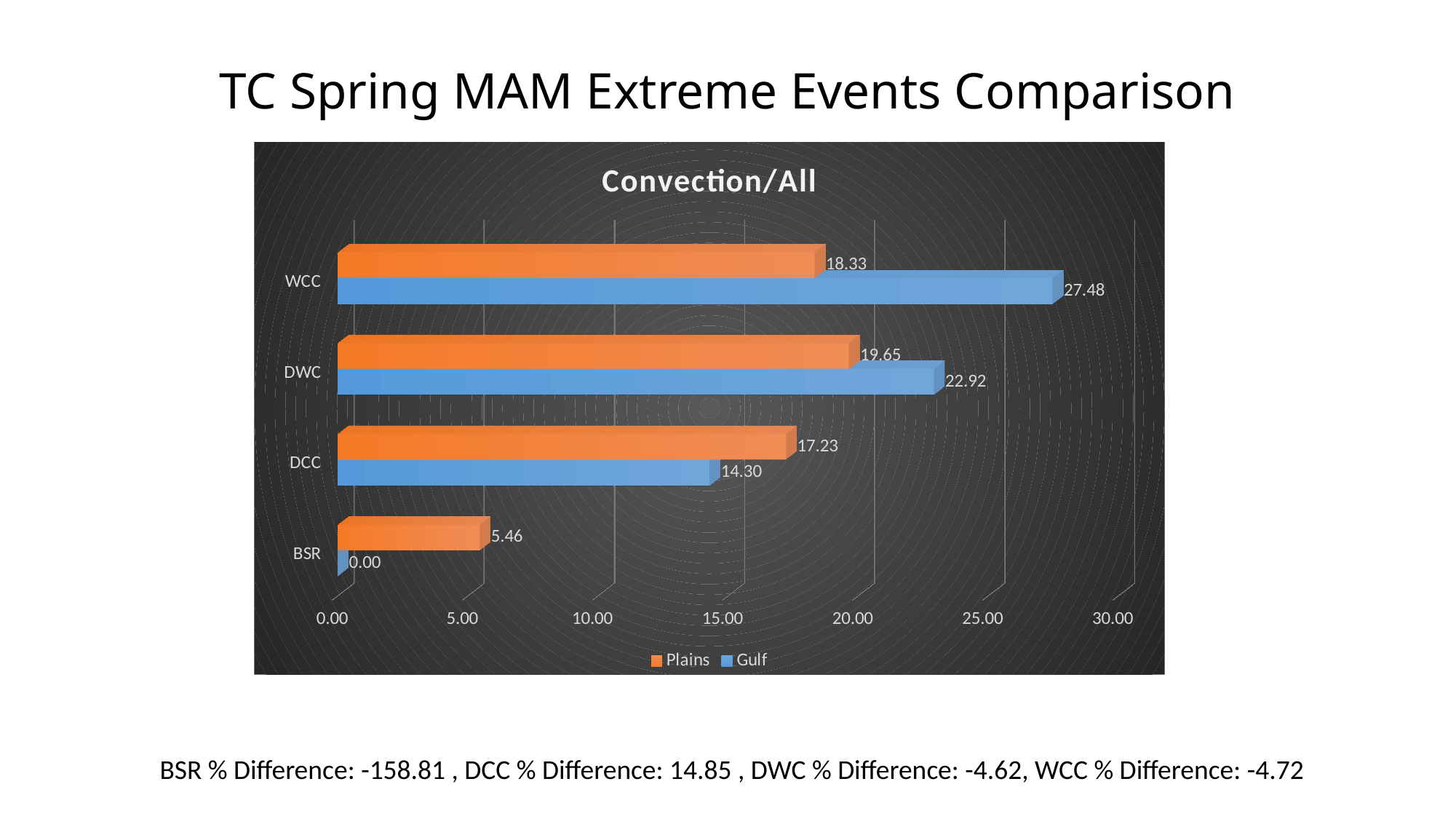
Which category has the lowest Plains value? BSR What kind of chart is shown? Bar chart What is the Plains value for DCC? 17.23 What is the Gulf value for BSR? 0.00 Which category has the highest Gulf value? WCC What is the Gulf value for WCC? 27.48 What is the Plains value for DWC? 19.65 How many categories are shown on the chart? 4 What is the title of the chart? Convection/All What is the difference between the Gulf and Plains values for WCC? 9.15 How many series does the legend list? 2 For DCC, which series has the larger value, Plains or Gulf? Plains